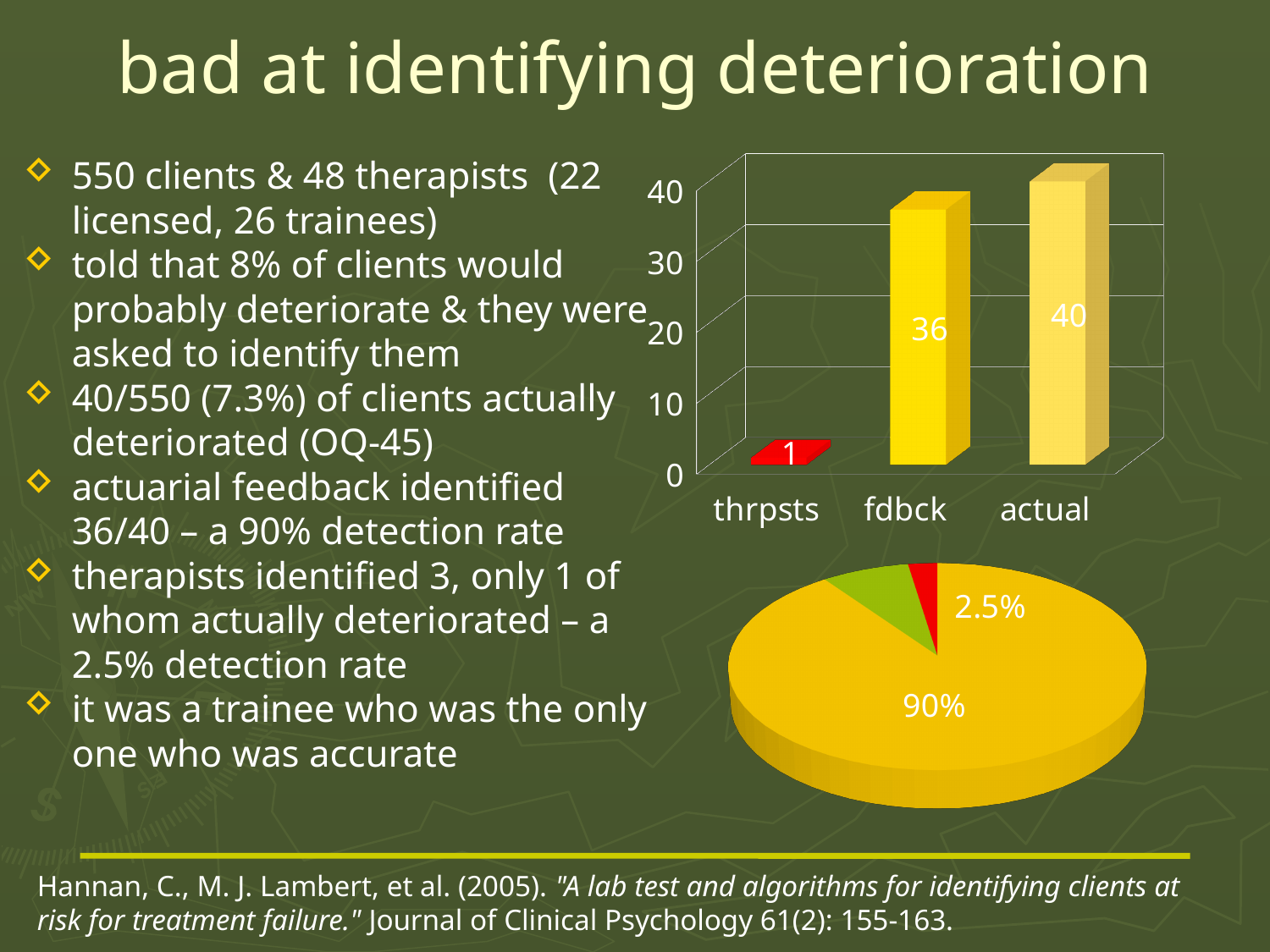
In the bar chart, is the value for fdbck greater or less than 30? greater In the pie chart, what share does the largest slice have? 90% What kind of chart is the chart at the top right of the slide? bar chart In the bar chart, what is the value for actual? 40 In the bar chart, what is the value for thrpsts? 1 In the bar chart, which category has the highest value? actual In the bar chart, what is the value for fdbck? 36 In the pie chart, what share is labelled on the red slice? 2.5% How many categories are shown in the bar chart? 3 In the bar chart, what is the difference between the values for actual and fdbck? 4 In the bar chart, which is larger, the value for fdbck or the value for thrpsts? fdbck In the bar chart, which category has the lowest value? thrpsts